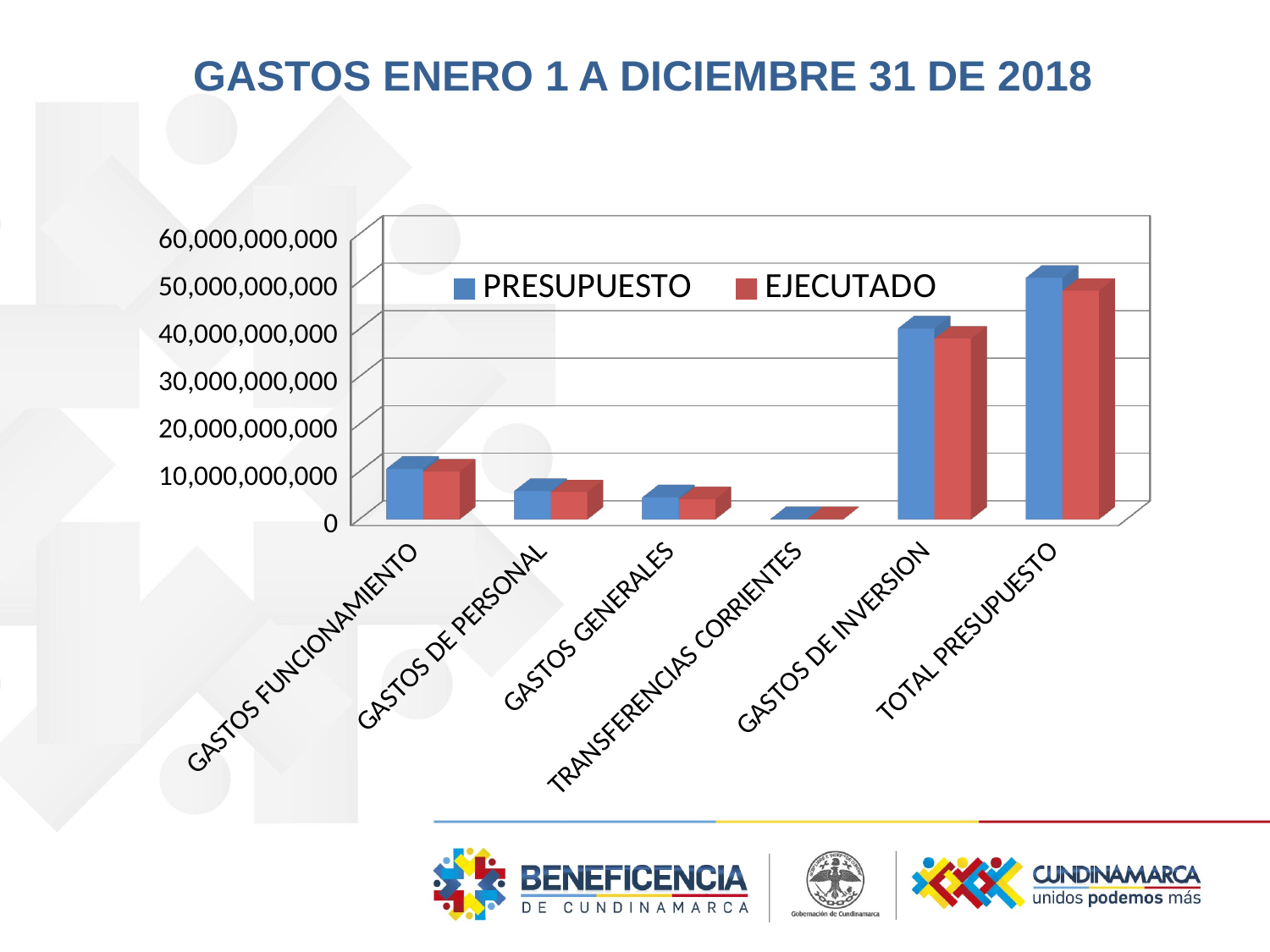
Is the PRESUPUESTO value for GASTOS DE INVERSION greater or less than 30,000,000,000? greater Which is larger, the PRESUPUESTO value for GASTOS DE INVERSION or for GASTOS DE PERSONAL? GASTOS DE INVERSION Which series is shown in blue in the legend? PRESUPUESTO Is the EJECUTADO value for GASTOS DE PERSONAL greater or less than 10,000,000,000? less Is the EJECUTADO value for TOTAL PRESUPUESTO greater or less than 40,000,000,000? greater How many categories are shown on the x axis? 6 What kind of chart is shown on the slide? bar chart Which category has the lowest EJECUTADO value? TRANSFERENCIAS CORRIENTES How many series does the legend list? 2 What is the title of the chart? GASTOS ENERO 1 A DICIEMBRE 31 DE 2018 Which category has the highest PRESUPUESTO value? TOTAL PRESUPUESTO